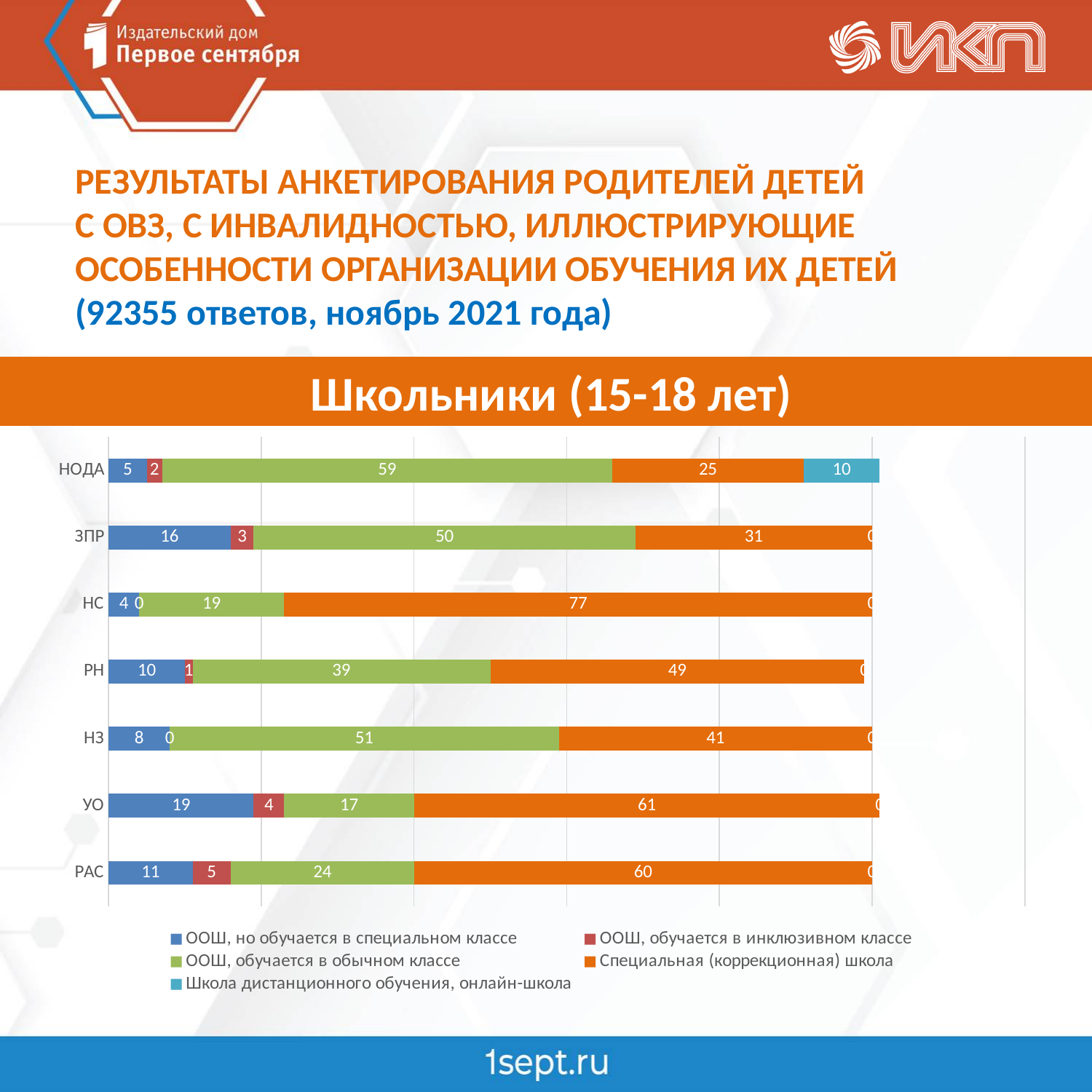
Which category has the highest value for 'Специальная (коррекционная) школа'? НС Which is larger: the 'ООШ, обучается в обычном классе' value for ЗПР or for НЗ? НЗ How many categories are shown on the vertical axis of the chart? 7 What is the value for 'Школа дистанционного обучения, онлайн-школа' in the НОДА category? 10 What is the difference between the 'Специальная (коррекционная) школа' values for УО and РАС? 1 What is the total of the stacked bar for ЗПР? 100 What is the value for 'Специальная (коррекционная) школа' in the НС category? 77 Which category has the lowest value for 'ООШ, обучается в обычном классе'? УО What kind of chart is shown on the slide? Stacked bar chart How many series does the legend list? 5 What is the value for 'ООШ, но обучается в специальном классе' in the УО category? 19 What is the value for 'ООШ, обучается в обычном классе' in the НОДА category? 59